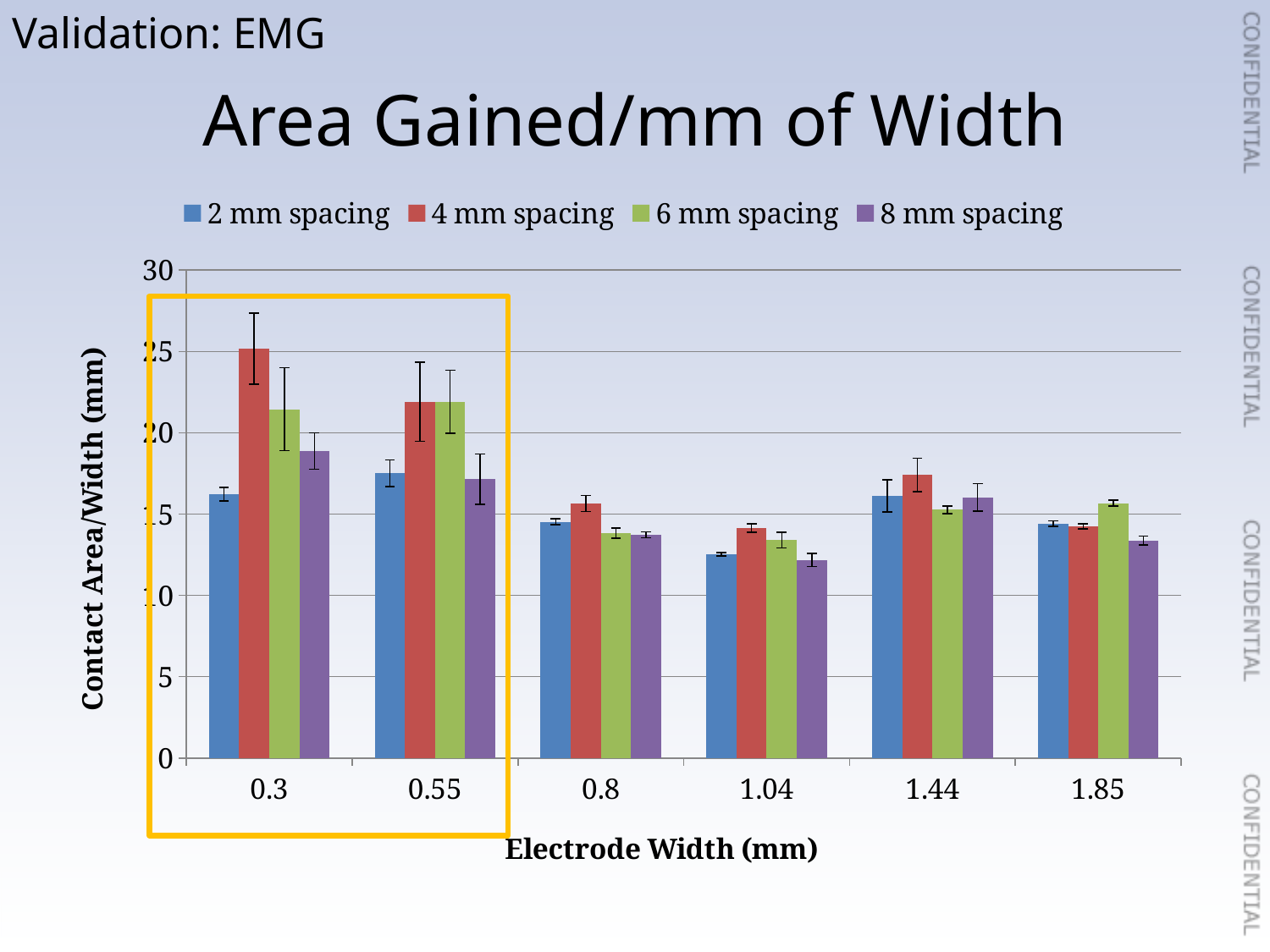
Is the value for 2 mm spacing at electrode width 1.04 greater or less than 15? less At electrode width 0.3, which is larger: 4 mm spacing or 2 mm spacing? 4 mm spacing For the 2 mm spacing series, do the values rise or fall from electrode width 0.55 to 1.04? fall Which series has the tallest bar at electrode width 0.3? 4 mm spacing Is the value for 4 mm spacing at electrode width 0.3 greater or less than 20? greater For the 2 mm spacing series, at which electrode width is the value lowest? 1.04 What is the title of the x axis? Electrode Width (mm) How many series does the legend list? 4 Is the value for 8 mm spacing at electrode width 0.3 greater or less than 15? greater At electrode width 1.04, which is larger: 4 mm spacing or 8 mm spacing? 4 mm spacing What kind of chart is shown on the slide? bar chart How many electrode width categories are shown on the x axis? 6